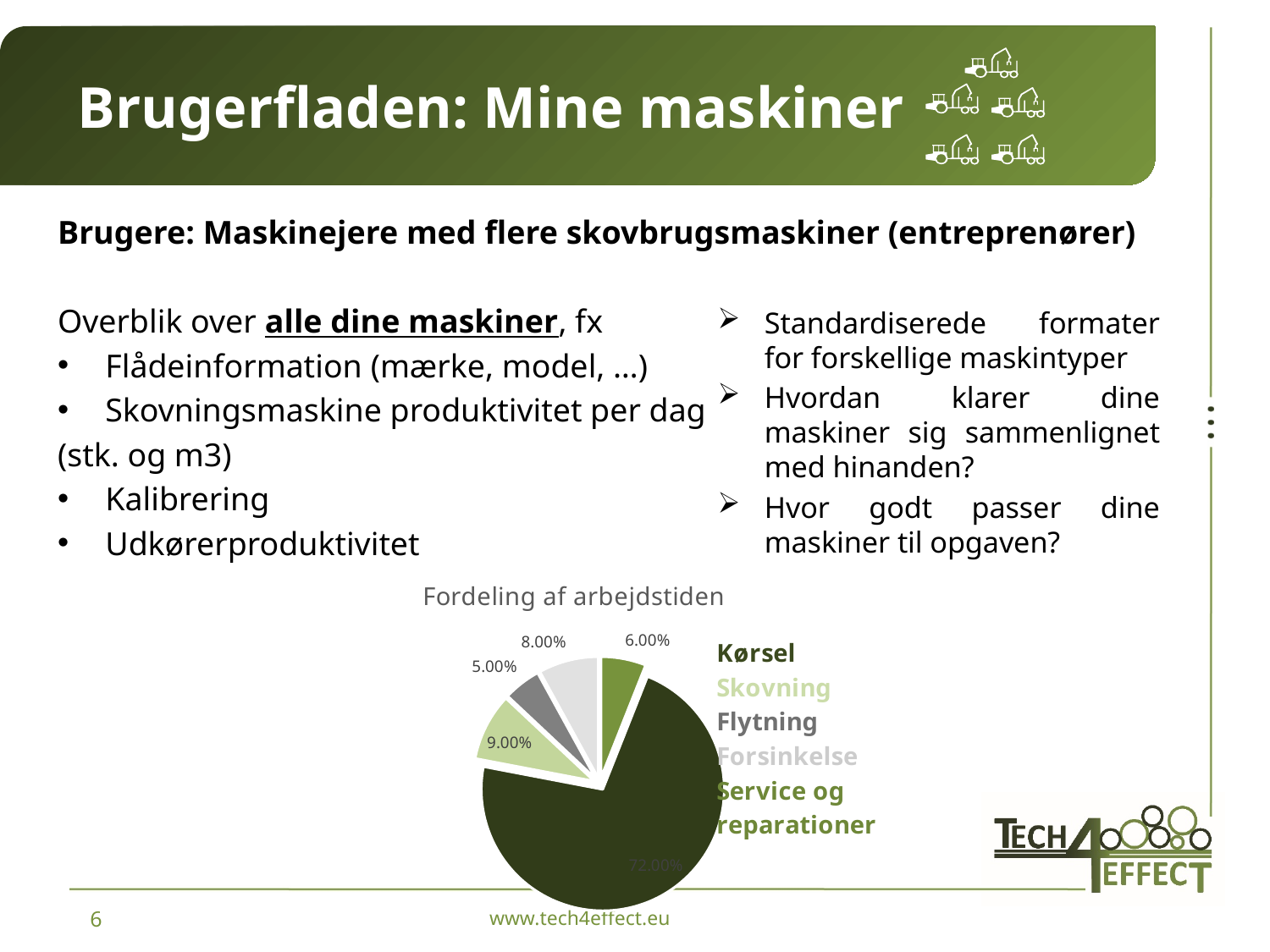
What share of the pie does Skovning represent? 72.00% What share of the pie does Service og reparationer represent? 8.00% What share of the pie does Flytning represent? 9.00% What is the title of the chart? Fordeling af arbejdstiden Which category has the smallest slice of the pie? Forsinkelse What type of chart is shown on the slide? pie chart Which is larger, the share for Forsinkelse or the share for Service og reparationer? Service og reparationer What is the difference between the shares of Kørsel and Skovning? 66.00% Which category has the largest slice of the pie? Skovning How many categories does the legend of the pie chart list? 5